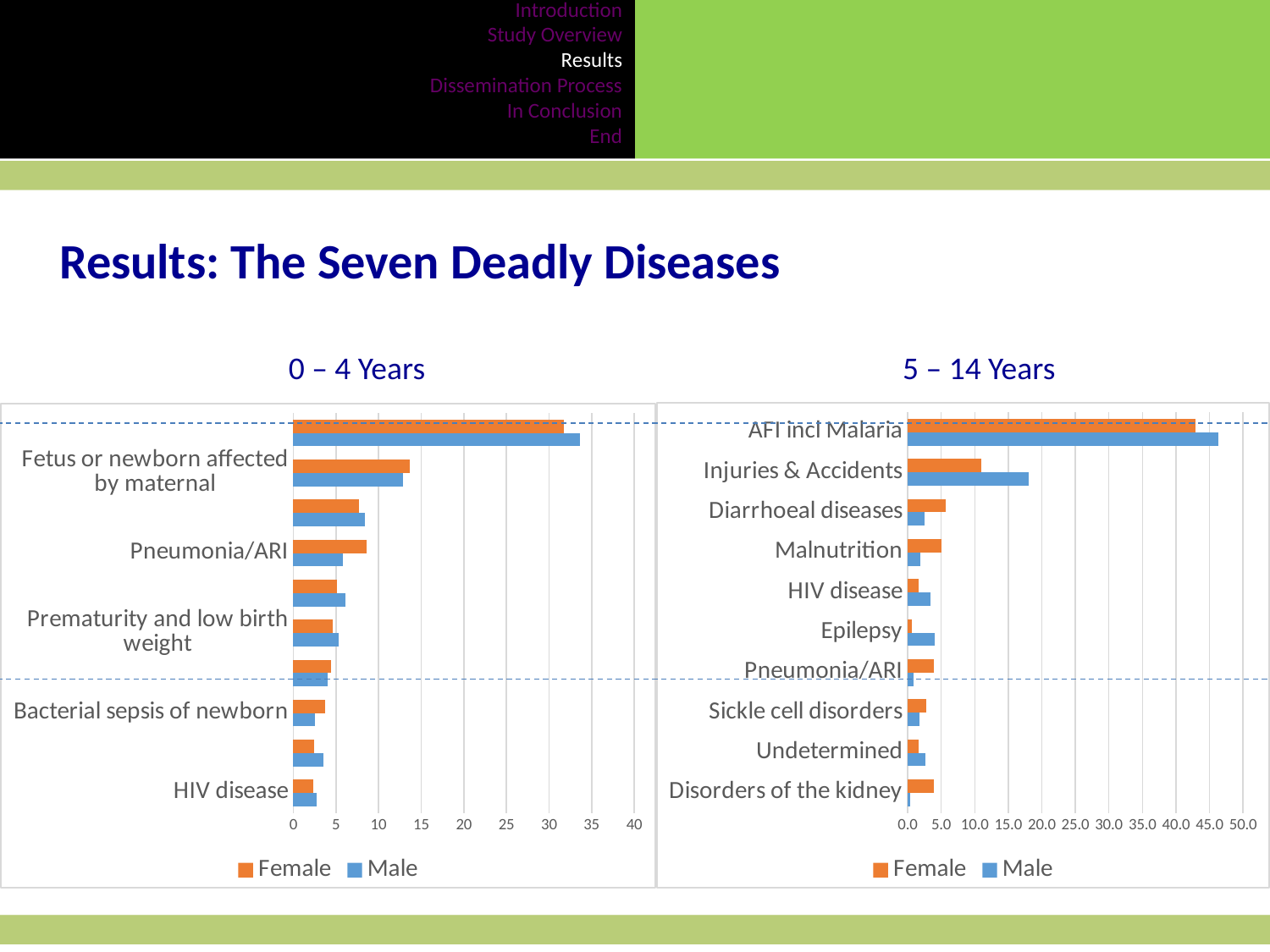
In the '5 – 14 Years' chart, which category has the lowest Female value? Epilepsy In the '5 – 14 Years' chart, is the Male value for AFI incl Malaria greater or less than 40.0? greater In the '5 – 14 Years' chart, which category has the highest Male value? AFI incl Malaria How many series does the legend of the '0 – 4 Years' chart list? 2 In the '5 – 14 Years' chart, is the Female value for Injuries & Accidents greater or less than 15.0? less In the '5 – 14 Years' chart, which is larger for Diarrhoeal diseases, the Female or the Male value? Female How many categories are shown on the '5 – 14 Years' chart? 10 What kind of chart is the '5 – 14 Years' chart? bar chart In the '0 – 4 Years' chart, which is larger for Pneumonia/ARI, the Female or the Male value? Female Which colour represents the Female series in the '0 – 4 Years' chart? orange In the '5 – 14 Years' chart, which is larger for Injuries & Accidents, the Female or the Male value? Male In the '0 – 4 Years' chart, is the Female value for Fetus or newborn affected by maternal greater or less than 10? greater